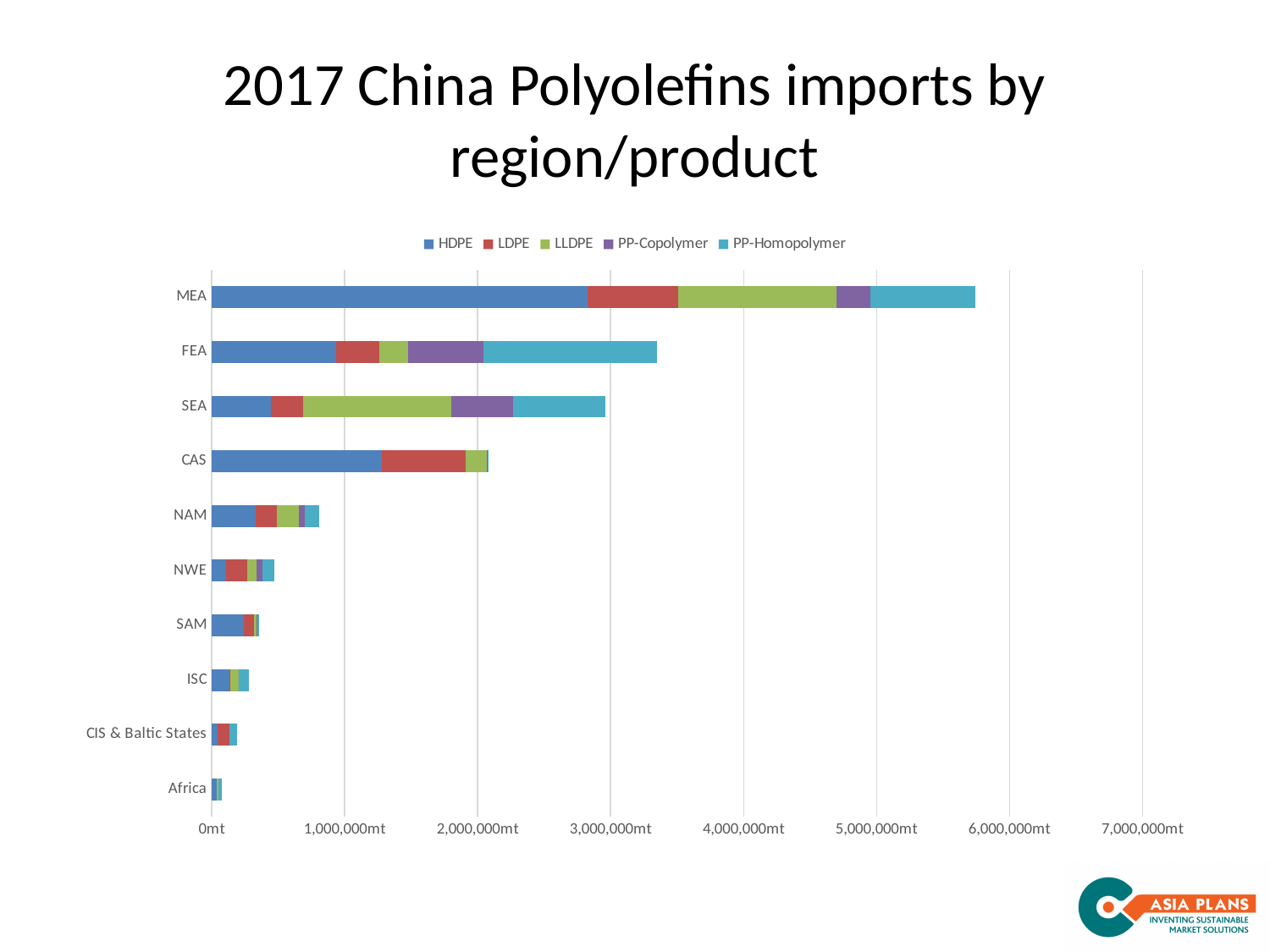
Is the total bar for SEA greater or less than 2,000,000mt? greater Which region has a larger total bar, FEA or SEA? FEA Which region has the largest total polyolefins imports? MEA Is the total bar for FEA greater or less than 3,000,000mt? greater Which series is shown in blue in the legend? HDPE Which region has the smallest total polyolefins imports? Africa Is the total bar for NAM greater or less than 1,000,000mt? less How many series does the legend list? 5 What kind of chart is shown on the slide? Stacked bar chart Which region has a larger total bar, NAM or NWE? NAM How many regions are shown on the chart? 10